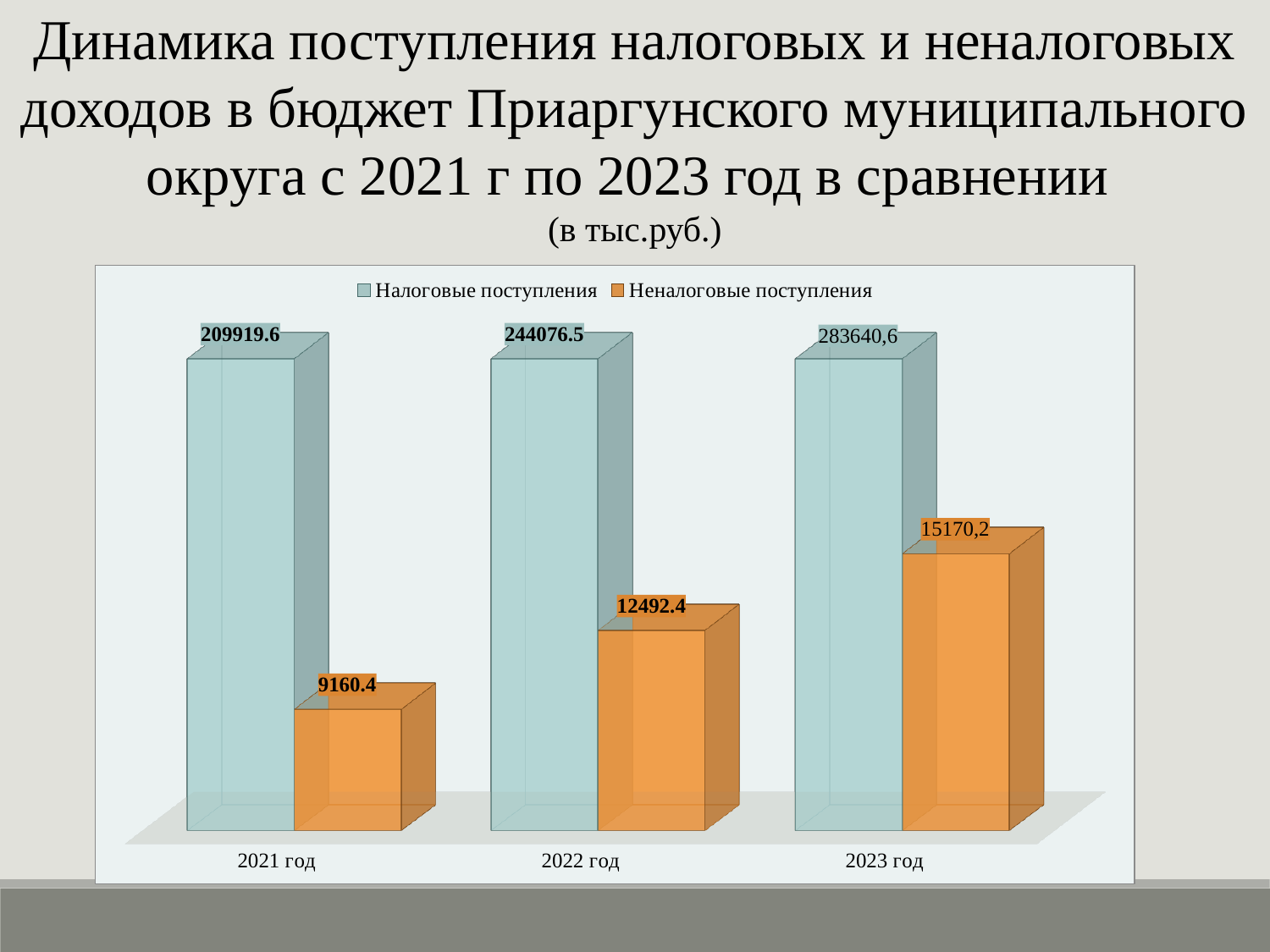
How many years are shown on the x axis? 3 What is the value of Неналоговые поступления for 2022 год? 12492.4 What kind of chart is shown on the slide? Bar chart Which is larger: Неналоговые поступления in 2022 год or in 2023 год? 2023 год How many series does the legend list? 2 Do the values of Налоговые поступления rise or fall from 2021 год to 2023 год? Rise What is the difference between Налоговые поступления in 2022 год and 2021 год? 34156.9 What is the value of Неналоговые поступления for 2021 год? 9160.4 In which year is Налоговые поступления the highest? 2023 год In which year is Неналоговые поступления the lowest? 2021 год What is the value of Налоговые поступления for 2023 год? 283640,6 What is the value of Налоговые поступления for 2021 год? 209919.6